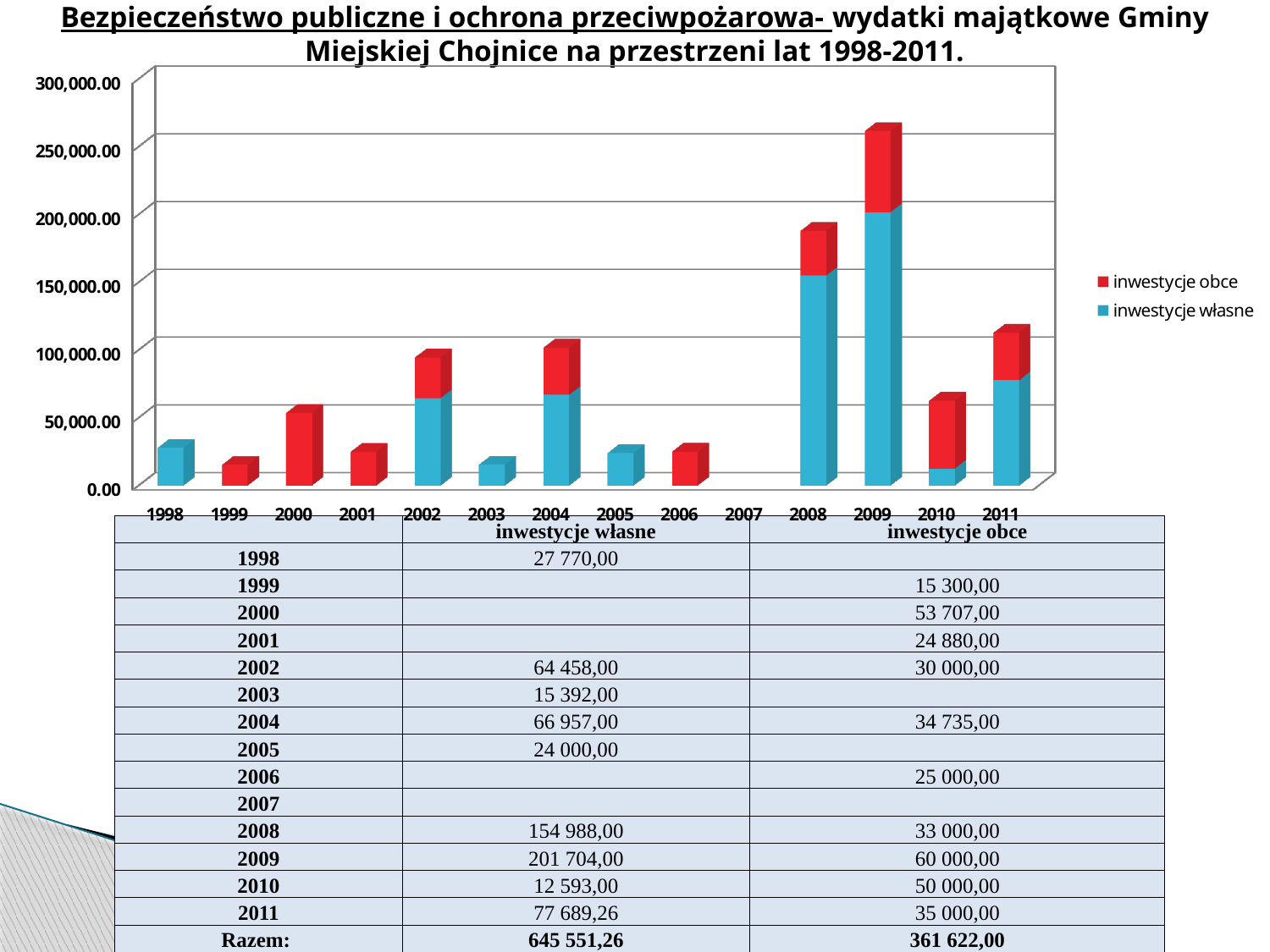
Which year has the tallest stacked bar in the chart? 2009 What is the difference between inwestycje własne in 2009 and in 2008? 46 716,00 Is the total stacked bar for 2008 greater or less than 150,000.00? greater What kind of chart is shown on the slide? bar chart What is the value of inwestycje własne for 2009? 201 704,00 How many years are shown on the x axis of the chart? 14 Does the inwestycje własne value rise or fall from 2009 to 2010? fall How many series does the chart legend list? 2 Which year has the larger inwestycje obce value, 2000 or 2001? 2000 What is the value of inwestycje obce for 2010? 50 000,00 What is the total of the stacked bar for 2009 (inwestycje własne plus inwestycje obce)? 261 704,00 Which colour represents inwestycje obce in the chart? red